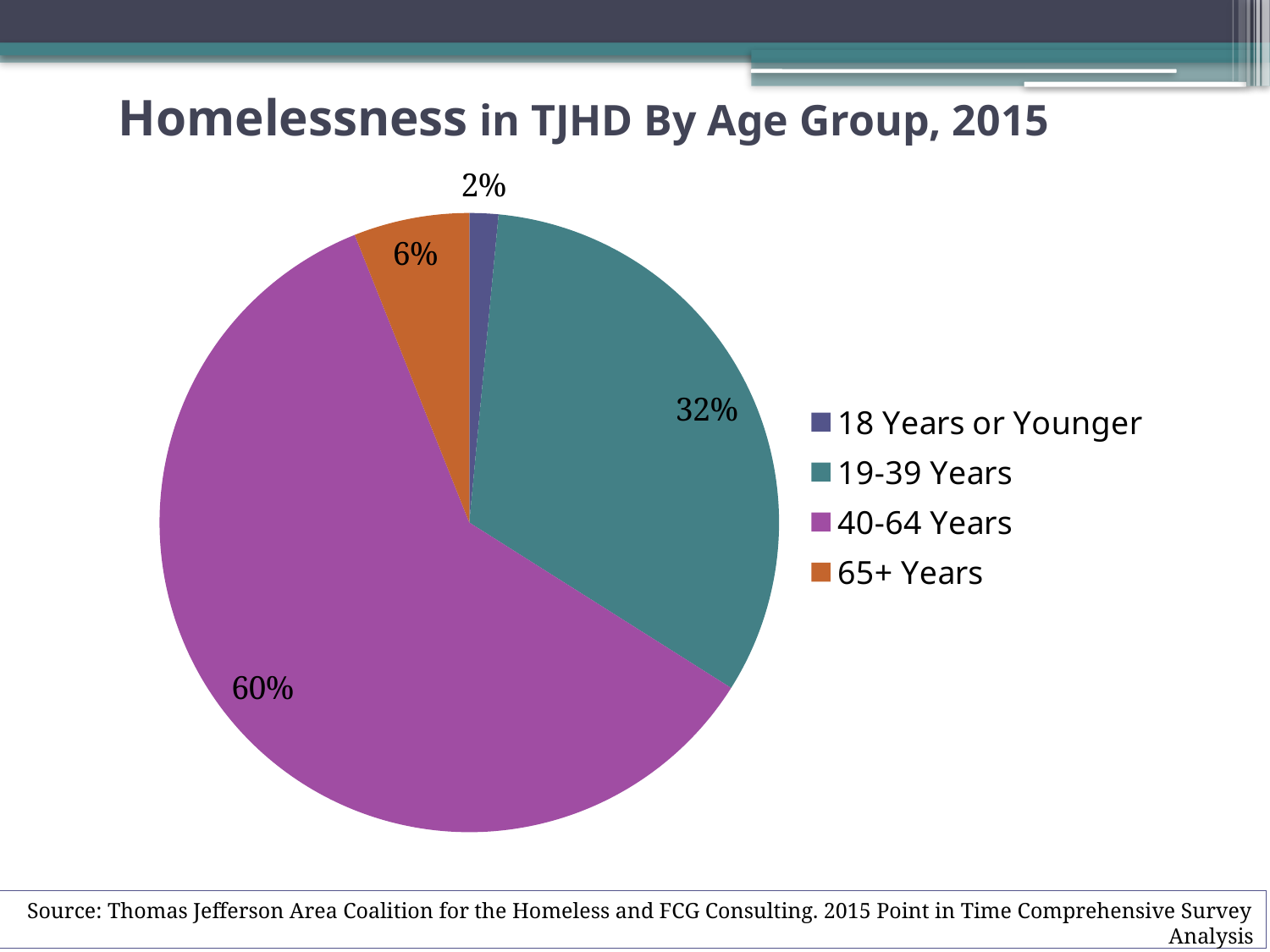
How many age groups are shown in the pie chart? 4 What share of the pie does the 40-64 Years group represent? 60% What colour represents the 19-39 Years group in the pie chart? Teal What kind of chart is shown on the slide? Pie chart What percentage is shown for the 19-39 Years group? 32% Which is larger, the share for 65+ Years or the share for 18 Years or Younger? 65+ Years Which age group has the smallest share of the pie? 18 Years or Younger What percentage is shown for the 65+ Years group? 6% Which age group has the largest share of the pie? 40-64 Years What is the difference in percentage points between the 40-64 Years and 19-39 Years groups? 28 What is the title of the chart? Homelessness in TJHD By Age Group, 2015 What percentage is shown for the 18 Years or Younger group? 2%